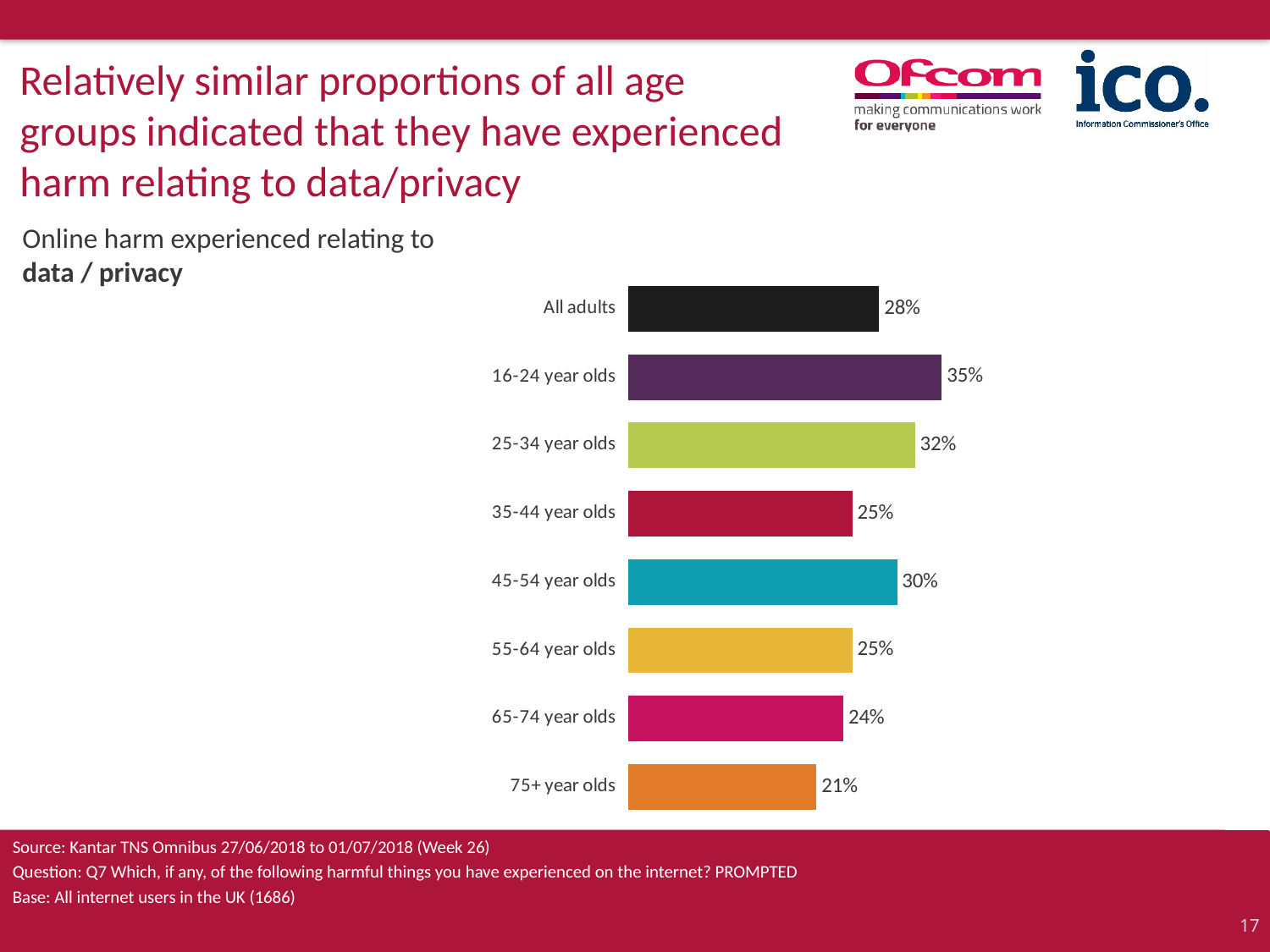
Which age group has the highest percentage in the chart? 16-24 year olds What percentage of 16-24 year olds indicated they have experienced online harm relating to data/privacy? 35% What is the difference between the values for 25-34 year olds and 35-44 year olds? 7 How many bars are shown in the chart? 8 What is the value shown for All adults in the chart? 28% Which age group has the lowest percentage in the chart? 75+ year olds What percentage is shown for 75+ year olds? 21% Which has a higher value: 45-54 year olds or 55-64 year olds? 45-54 year olds What type of chart is used on this slide? Bar chart What colour is the bar for All adults? Black What is the difference in percentage points between 16-24 year olds and 75+ year olds? 14 What is the value for 45-54 year olds? 30%